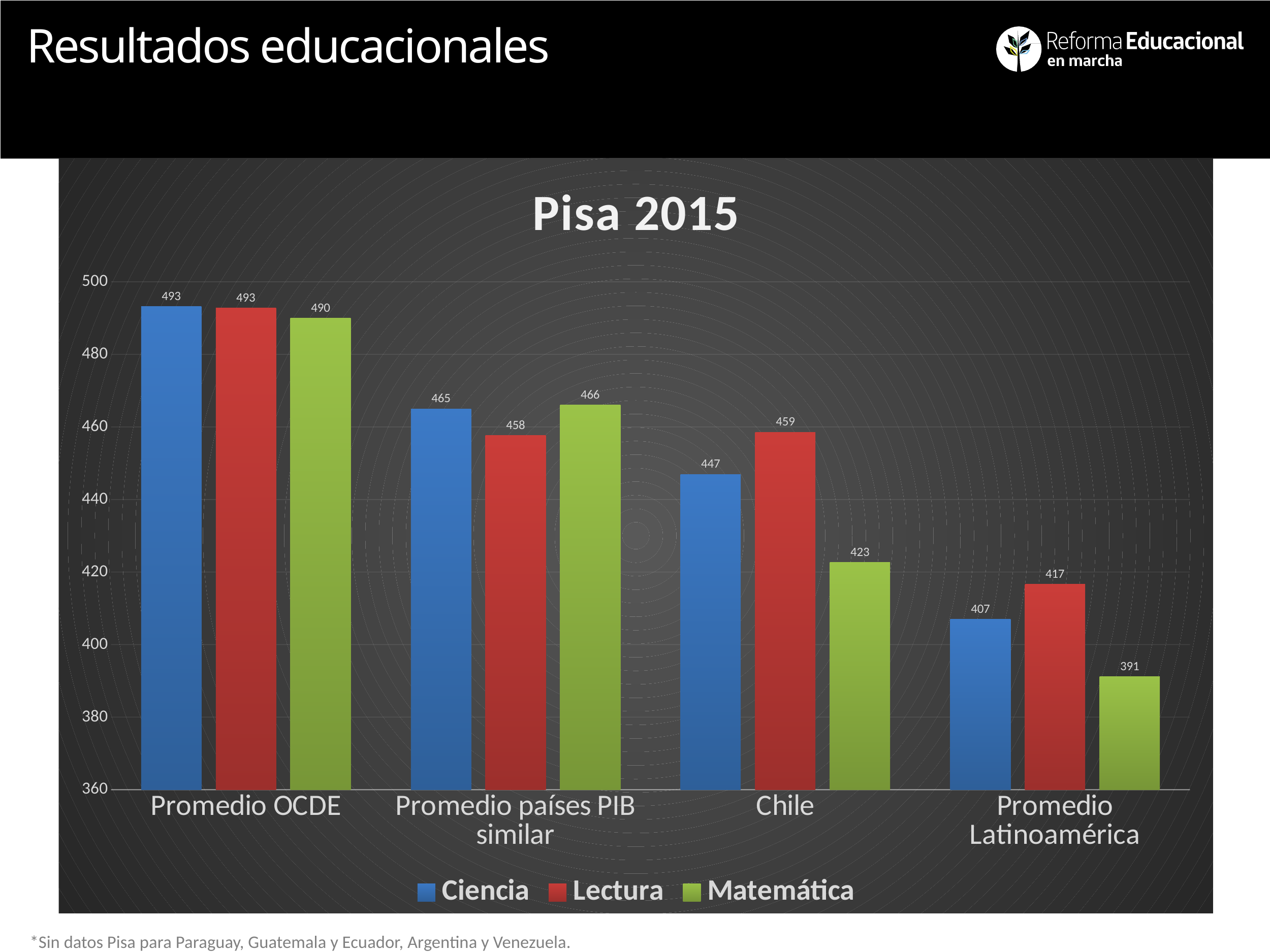
What is the difference between the Lectura and Matemática scores for Chile? 36 Which is larger for Chile: the Ciencia score or the Lectura score? Lectura What is the Matemática score for Promedio Latinoamérica? 391 What is the Lectura score for Promedio países PIB similar? 458 Which category has the lowest Matemática score? Promedio Latinoamérica Which category has the highest Lectura score? Promedio OCDE What is the title of the chart? Pisa 2015 What kind of chart is shown on the slide? Bar chart Do the Ciencia scores rise or fall from Promedio OCDE to Promedio Latinoamérica? Fall How many series does the legend list? 3 What is the Ciencia score for Chile in the Pisa 2015 chart? 447 How many categories are shown on the x axis? 4